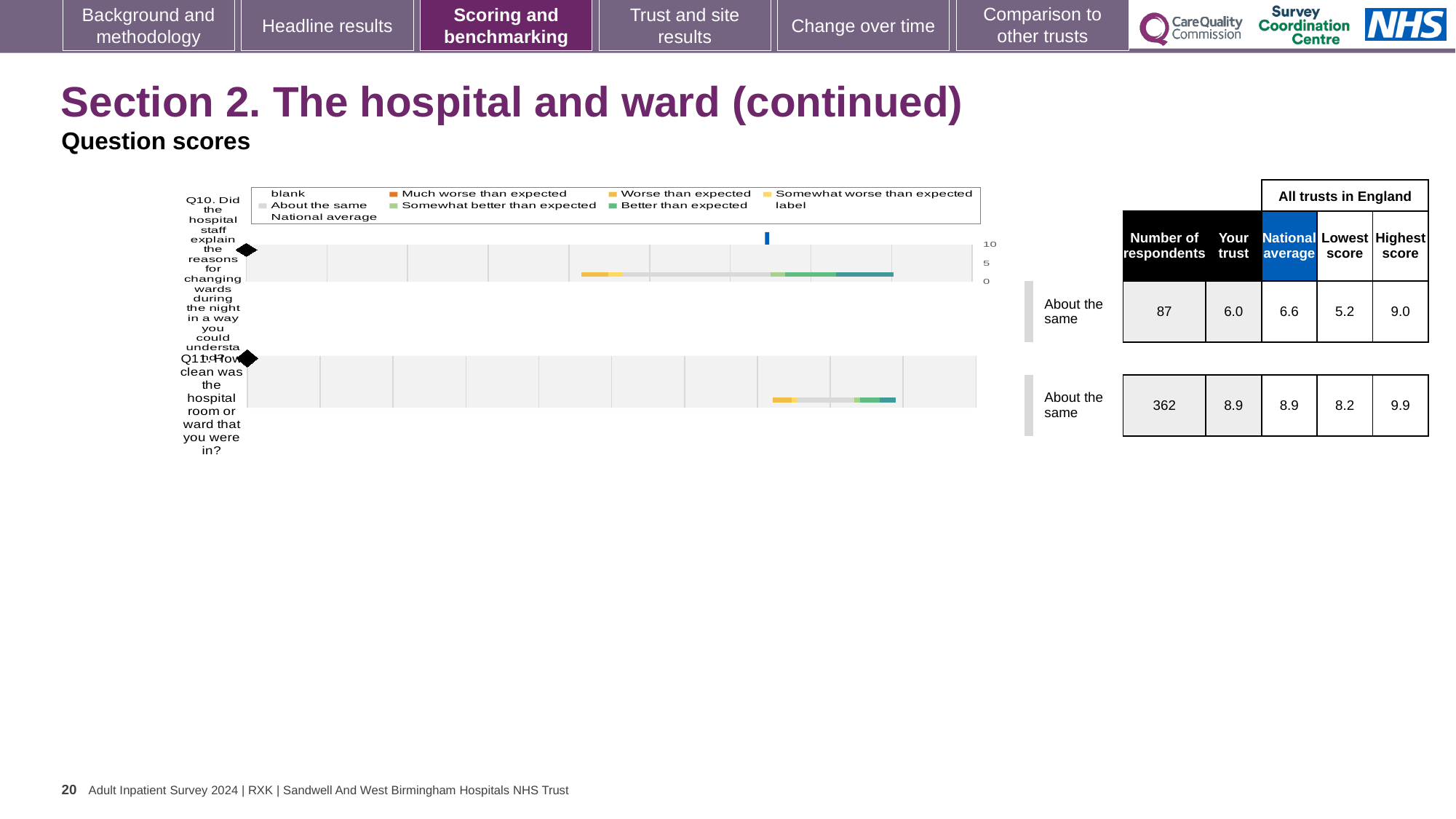
Is the 'Your trust' score for Q11 greater or less than 5 on the chart axis? greater What is the number of respondents for Q11 (how clean was the hospital room or ward)? 362 What is the highest score across all trusts in England for Q10? 9.0 For Q10, which is larger: the 'Your trust' score or the national average? National average What is the 'Your trust' score for Q10 (explaining reasons for changing wards during the night)? 6.0 What is the maximum value shown on the chart's score axis? 10 How many survey questions are plotted on the slide? 2 What is the difference between the highest score and the lowest score for Q11? 1.7 What kind of chart is used to show the question scores for Q10 and Q11? bar chart What is the difference between the national average and the 'Your trust' score for Q10? 0.6 What benchmark category is shown for Q10? About the same What is the national average score for Q10? 6.6